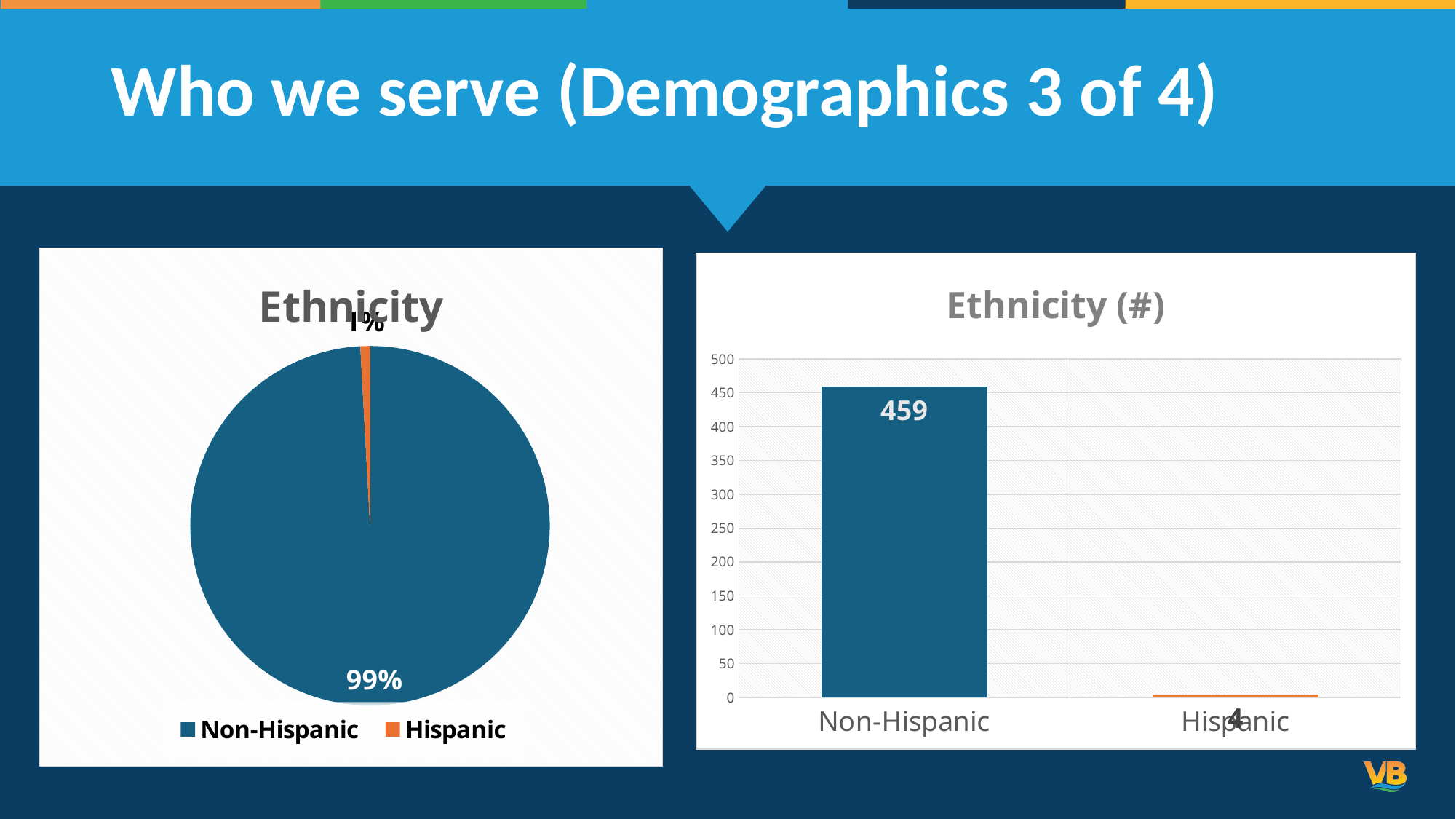
In the "Ethnicity" pie chart, which slice is the largest? Non-Hispanic In the "Ethnicity (#)" chart, what is the difference between the Non-Hispanic and Hispanic values? 455 In the "Ethnicity" pie chart, what colour is the Hispanic slice? Orange In the "Ethnicity" pie chart, what share of the pie is Non-Hispanic? 99% What kind of chart is the "Ethnicity (#)" chart on the right? Bar chart In the "Ethnicity" pie chart, how many categories does the legend list? 2 In the "Ethnicity (#)" chart, what is the value for Hispanic? 4 In the "Ethnicity" pie chart, what share of the pie is Hispanic? 1% In the "Ethnicity (#)" chart, is the value for Non-Hispanic greater or less than 400? greater In the "Ethnicity (#)" chart, which category has the lowest value? Hispanic In the "Ethnicity (#)" chart, what is the value for Non-Hispanic? 459 What kind of chart is the "Ethnicity" chart on the left? Pie chart